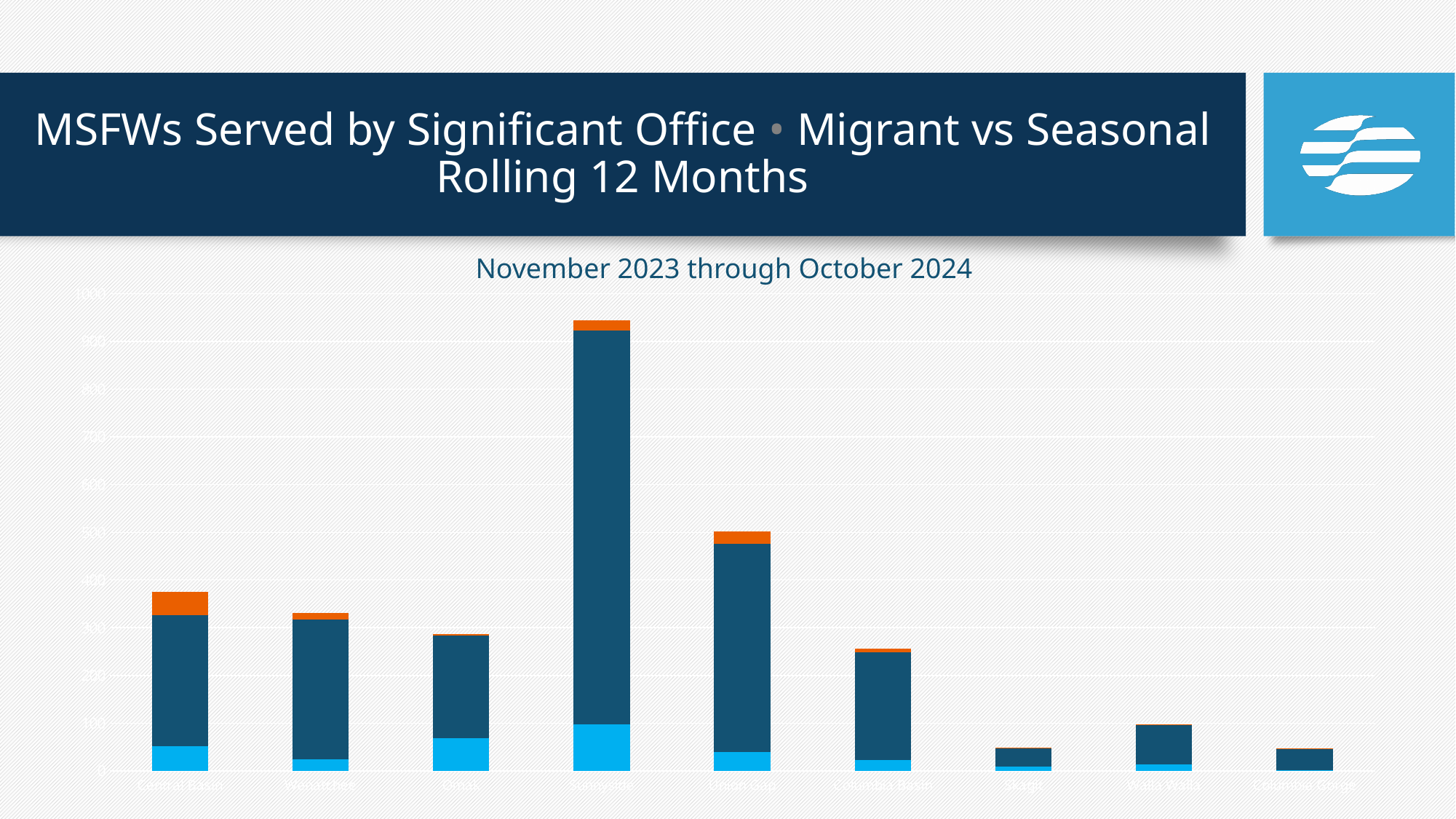
How many bars (categories) are plotted in the chart? 9 Is the total of the seventh bar from the left greater or less than 100? less What kind of chart is shown on the slide? bar chart Which is taller, the fourth bar from the left or the fifth bar from the left? the fourth bar Which is taller, the first bar from the left or the second bar from the left? the first bar Is the total of the fourth bar from the left greater or less than 800? greater What date range is given in the chart's title above the plot area? November 2023 through October 2024 Which is taller, the eighth bar from the left or the ninth bar from the left? the eighth bar Is the total of the fifth bar from the left greater or less than 400? greater How many differently coloured segments make up each stacked bar? 3 Which bar in the chart is the tallest? the fourth bar from the left